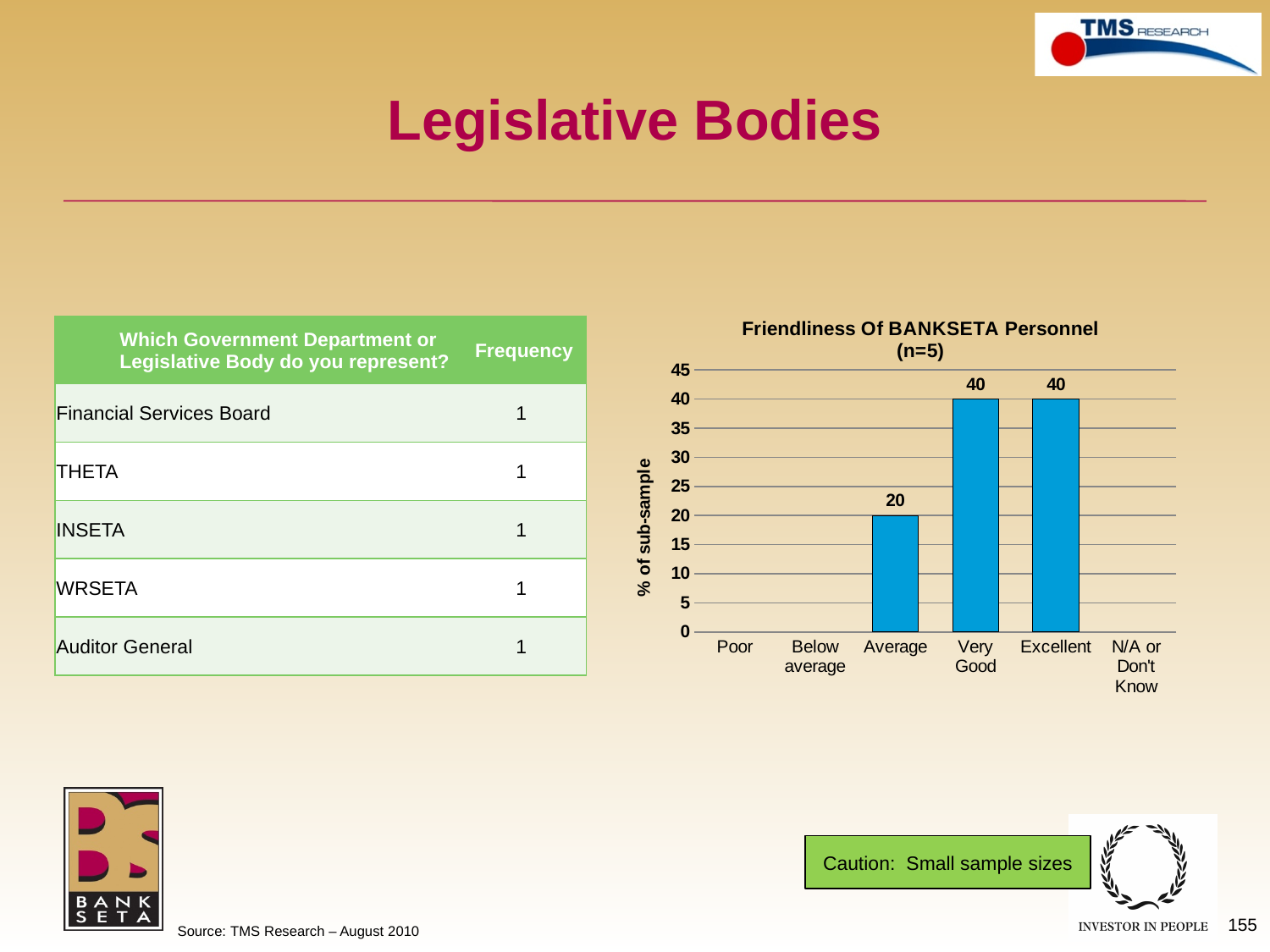
How many categories are shown on the x axis of the Friendliness Of BANKSETA Personnel chart? 6 What kind of chart is the Friendliness Of BANKSETA Personnel chart? bar chart Is the value for Excellent in the Friendliness Of BANKSETA Personnel chart greater or less than 35? greater Which is larger in the Friendliness Of BANKSETA Personnel chart, the value for Very Good or the value for Average? Very Good What is the value for Excellent in the Friendliness Of BANKSETA Personnel chart? 40 Which two categories share the highest value in the Friendliness Of BANKSETA Personnel chart? Very Good and Excellent What is the value for Average in the Friendliness Of BANKSETA Personnel chart? 20 Is the value for Average in the Friendliness Of BANKSETA Personnel chart greater or less than 25? less What is the value for Very Good in the Friendliness Of BANKSETA Personnel chart? 40 How many categories in the Friendliness Of BANKSETA Personnel chart have a visible bar? 3 What is the label on the y axis of the Friendliness Of BANKSETA Personnel chart? % of sub-sample What is the difference between the values for Excellent and Average in the Friendliness Of BANKSETA Personnel chart? 20